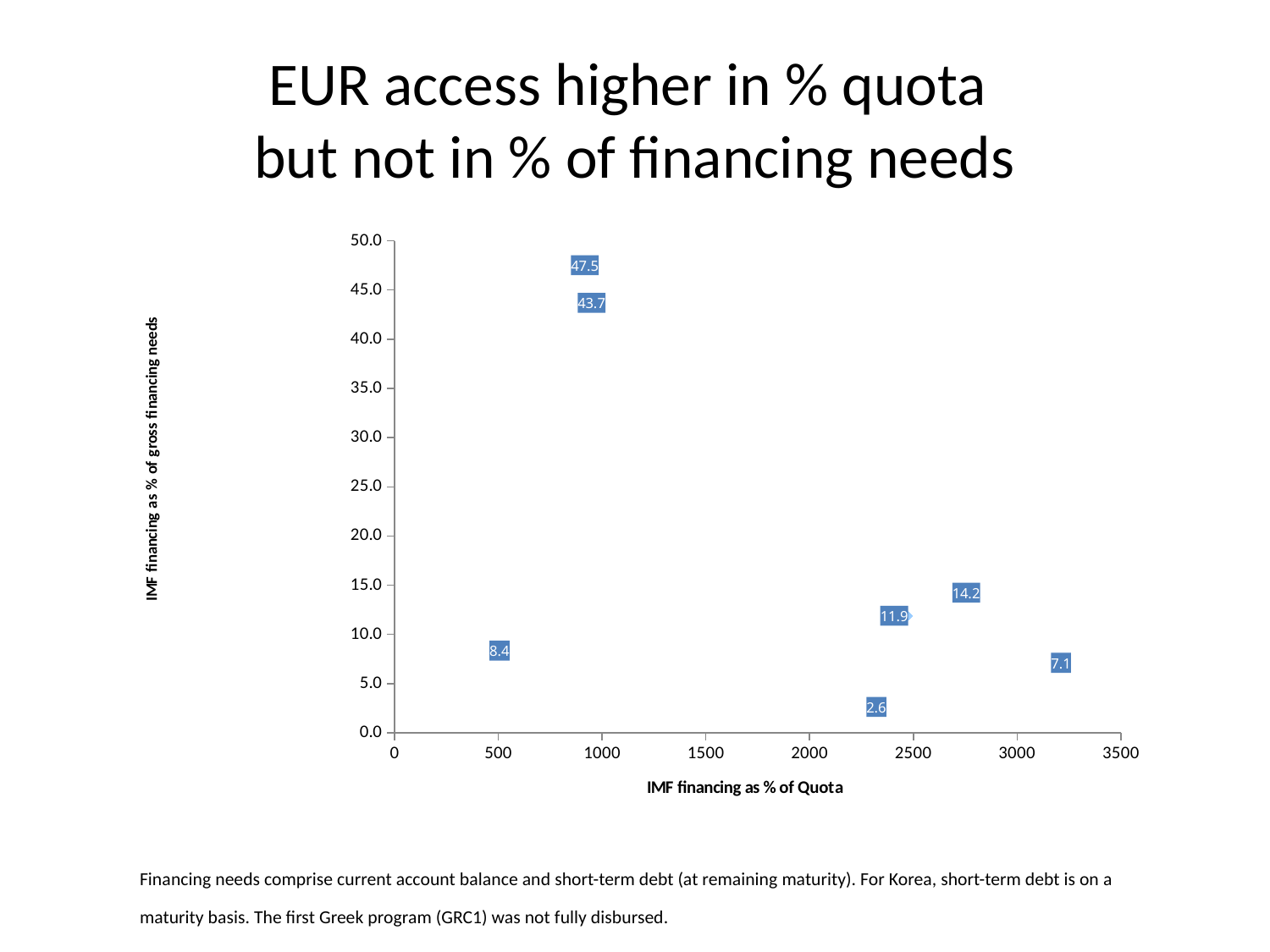
What kind of chart is shown on the slide? scatter chart What is the title of the y axis of the chart? IMF financing as % of gross financing needs Which is larger, the point labeled 14.2 or the point labeled 11.9? 14.2 Is the x-axis value (IMF financing as % of Quota) of the point labeled 2.6 greater or less than 2000? greater What is the difference between the highest labeled value (47.5) and the lowest labeled value (2.6)? 44.9 Is the x-axis value (IMF financing as % of Quota) of the point labeled 7.1 greater or less than 3000? greater What is the difference between the two highest labeled values, 47.5 and 43.7? 3.8 What is the title of the x axis of the chart? IMF financing as % of Quota What is the highest value labeled on the chart? 47.5 How many data points are plotted on the chart? 7 What is the lowest value labeled on the chart? 2.6 Is the x-axis value (IMF financing as % of Quota) of the point labeled 47.5 greater or less than 1500? less